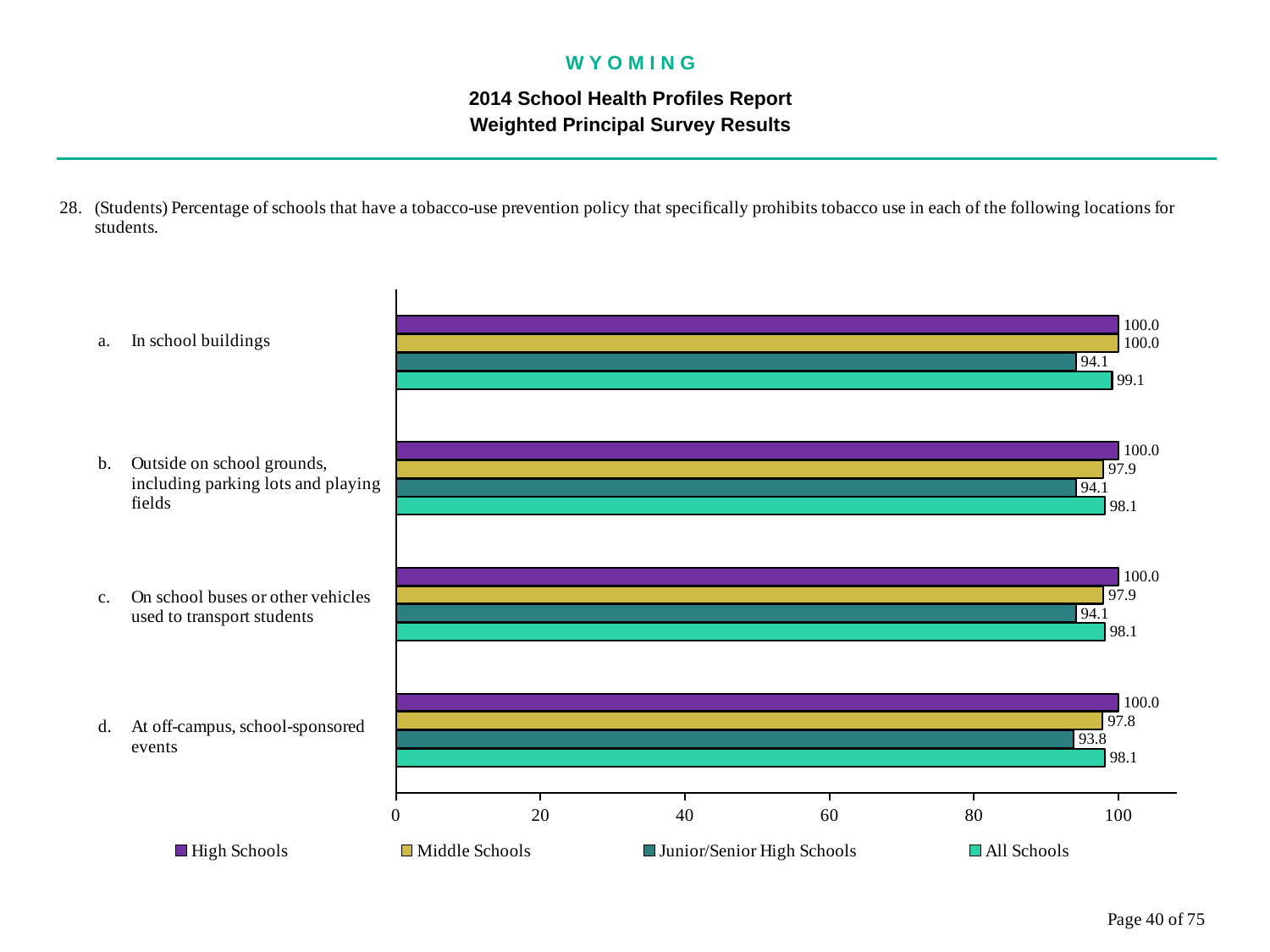
Which series is shown in purple in the legend? High Schools What is the difference between the All Schools values for 'In school buildings' and 'At off-campus, school-sponsored events'? 1.0 What is the value for Middle Schools for 'In school buildings'? 100.0 Which is larger for 'Outside on school grounds, including parking lots and playing fields': the Middle Schools value or the All Schools value? All Schools How many location categories are shown on the chart? 4 What is the value for Junior/Senior High Schools for 'At off-campus, school-sponsored events'? 93.8 What is the value for All Schools for 'Outside on school grounds, including parking lots and playing fields'? 98.1 What is the value for Middle Schools for 'On school buses or other vehicles used to transport students'? 97.9 Which series has the lowest value for 'In school buildings'? Junior/Senior High Schools How many series does the legend list? 4 What kind of chart is shown on the slide? Bar chart What is the difference between the High Schools and Junior/Senior High Schools values for 'At off-campus, school-sponsored events'? 6.2